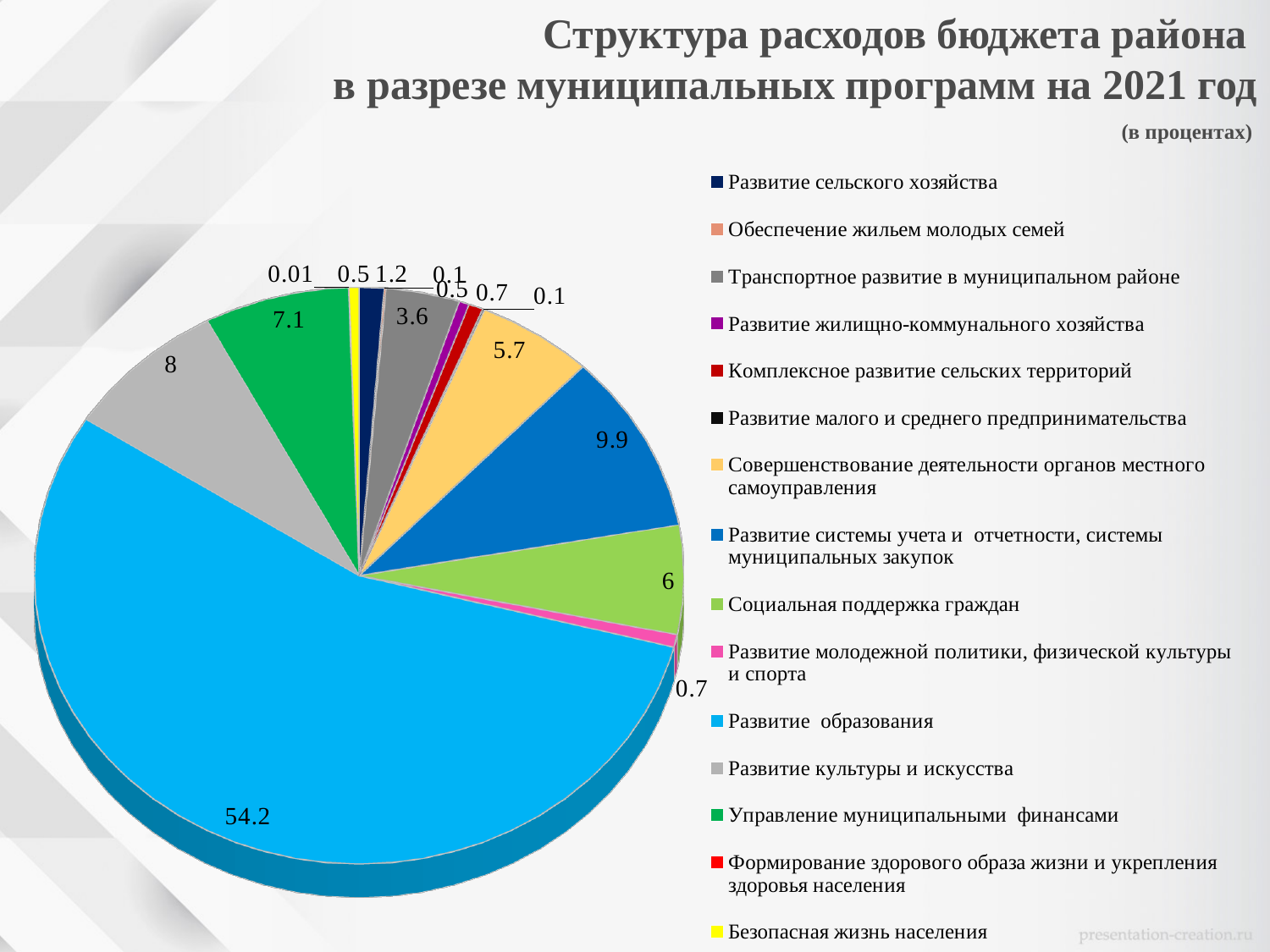
How many categories does the legend list? 15 What is the title of the chart? Структура расходов бюджета района в разрезе муниципальных программ на 2021 год What is the value shown for Развитие культуры и искусства? 8 What is the value shown for Развитие образования? 54.2 Which is larger: the value for Развитие культуры и искусства or the value for Социальная поддержка граждан? Развитие культуры и искусства What is the value shown for Управление муниципальными финансами? 7.1 What kind of chart is shown on the slide? pie chart What is the value shown for Развитие системы учета и отчетности, системы муниципальных закупок? 9.9 What is the value shown for Социальная поддержка граждан? 6 What is the difference between the values for Развитие образования and Развитие системы учета и отчетности, системы муниципальных закупок? 44.3 Which category has the largest share of the pie? Развитие образования What is the value shown for Совершенствование деятельности органов местного самоуправления? 5.7